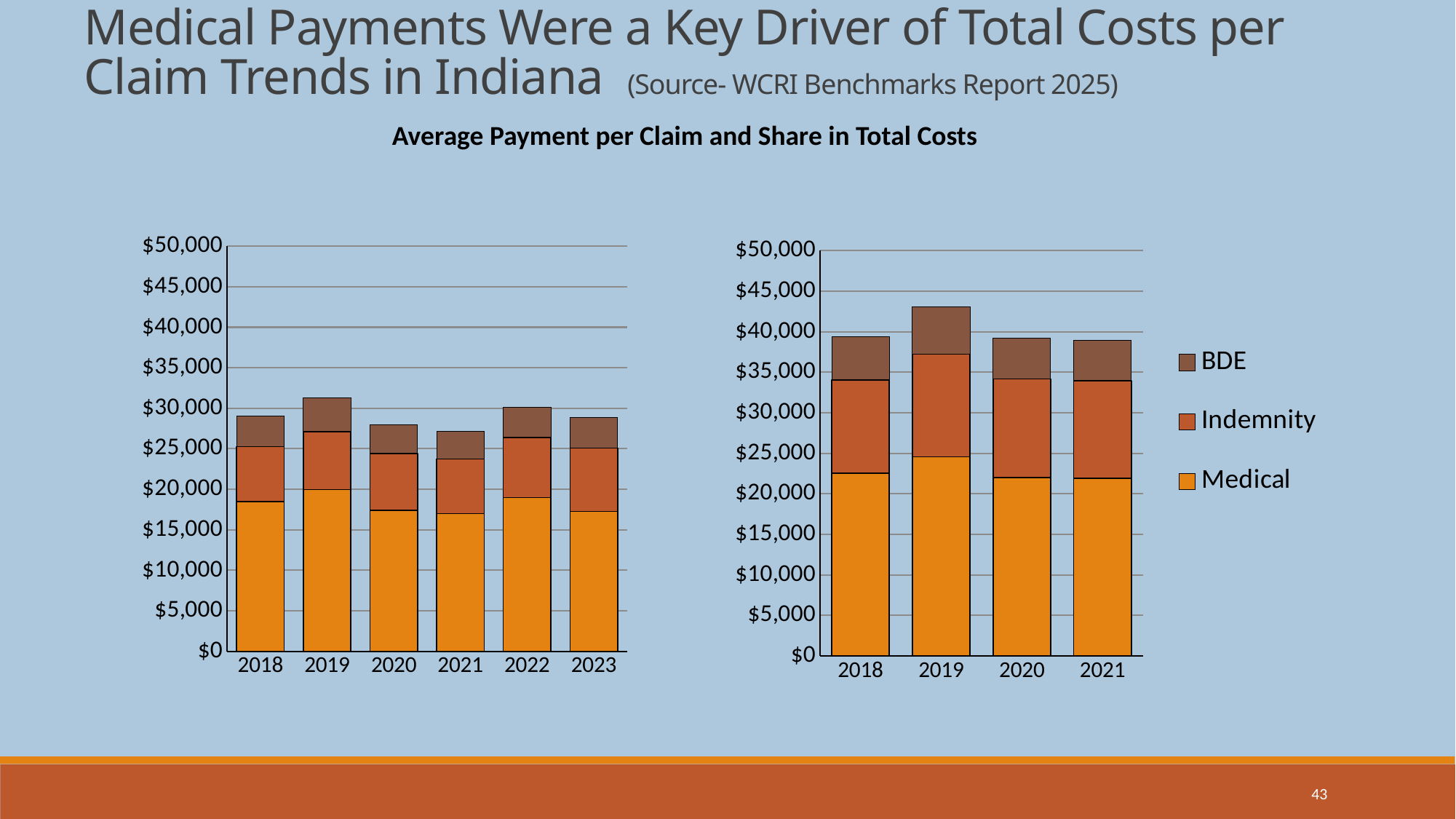
In the right chart, which year has the highest total bar? 2019 In the left chart, is the Medical segment for 2018 greater or less than $20,000? less Which series is shown in the bottom (orange) segment of each bar? Medical In the left chart, is the total bar for 2019 greater or less than $30,000? greater In the left chart, which year has the lowest total bar? 2021 In the right chart, is the total bar for 2019 greater or less than $40,000? greater How many series does the legend list? 3 In the right chart, is the total bar for 2019 larger than the total bar for 2020? Yes In the left chart, which year has the highest total bar? 2019 How many years are shown on the x axis of the left chart? 6 What kind of chart is the left chart on the slide? stacked bar chart How many years are shown on the x axis of the right chart? 4